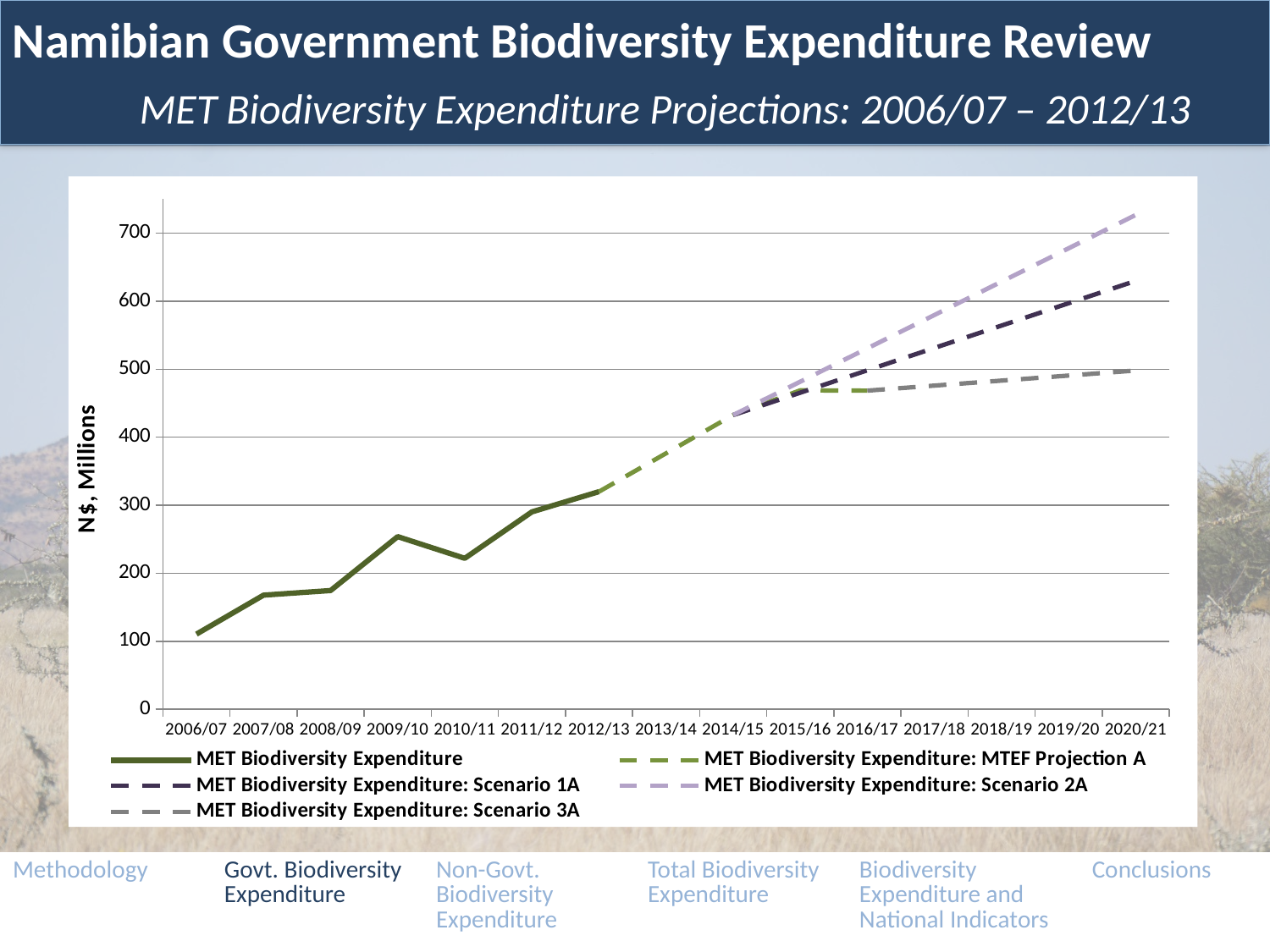
What kind of chart is shown on the slide? line chart Is the MET Biodiversity Expenditure value for 2009/10 greater or less than 200? greater Does the MET Biodiversity Expenditure series generally rise or fall from 2006/07 to 2012/13? rise Which scenario series reaches the highest value in 2020/21? MET Biodiversity Expenditure: Scenario 2A How many fiscal years are shown along the x axis? 15 In 2020/21, which is larger: Scenario 1A or Scenario 3A? Scenario 1A Is the MET Biodiversity Expenditure: Scenario 2A value for 2020/21 greater or less than 700? greater Is the MET Biodiversity Expenditure value for 2011/12 greater or less than 300? less What is the label of the vertical axis? N$, Millions How many series does the legend list? 5